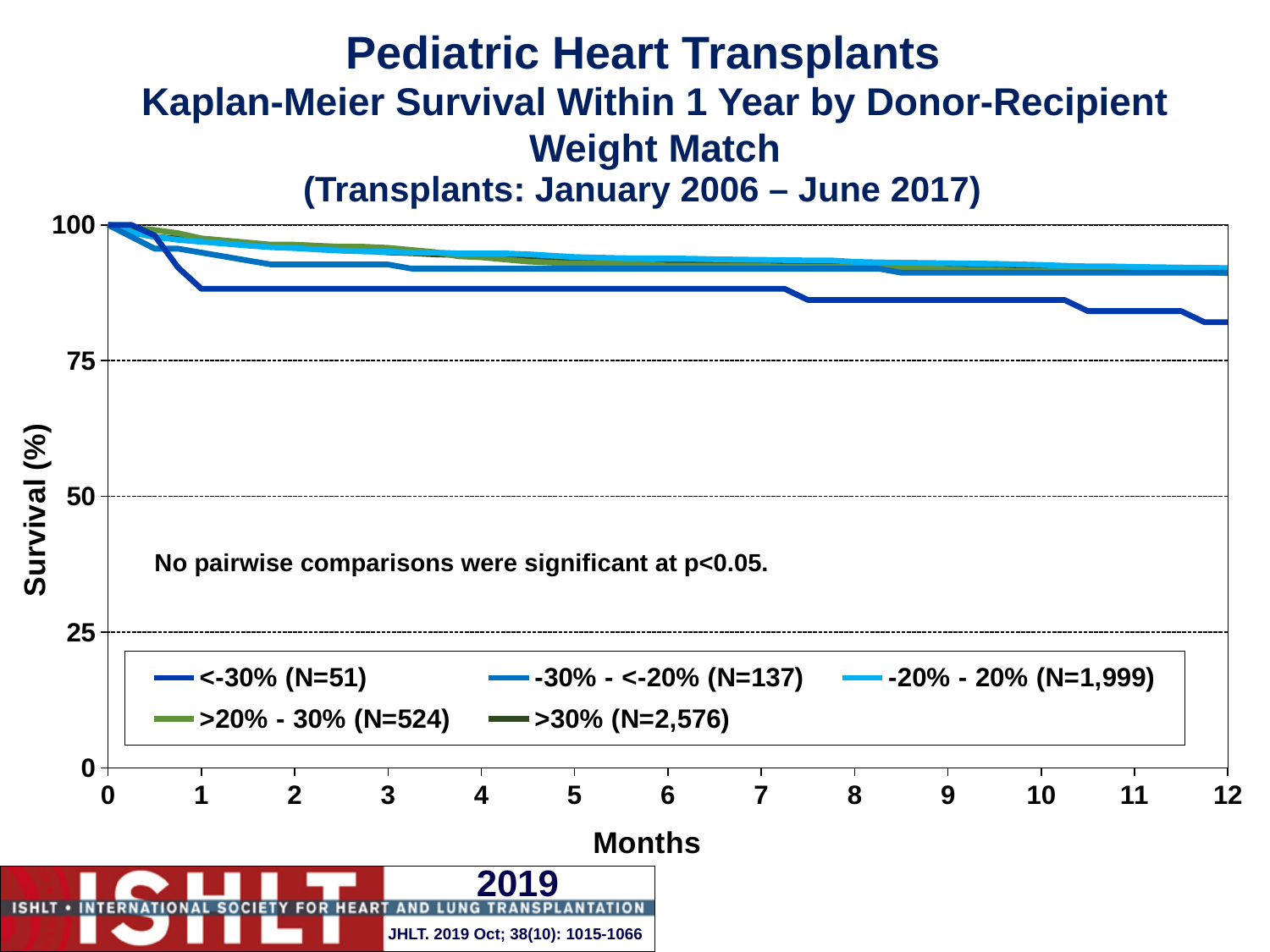
What is the highest value shown on the x axis? 12 What kind of chart is shown on the slide? Line chart What is the label of the y axis? Survival (%) At 2 months, which group has higher survival: <-30% (N=51) or >30% (N=2,576)? >30% (N=2,576) Is the survival for the <-30% (N=51) group at 6 months greater or less than 100? less Is the survival for the >30% (N=2,576) group at 12 months greater or less than 75? greater Do the survival curves rise or fall as months increase? Fall What is the N for the -20% - 20% group in the legend? 1,999 How many series does the legend list? 5 Is the survival for the <-30% (N=51) group at 12 months greater or less than 75? greater Which weight-match group has the lowest survival at 12 months? <-30% (N=51) At 12 months, which group has higher survival: <-30% (N=51) or -20% - 20% (N=1,999)? -20% - 20% (N=1,999)